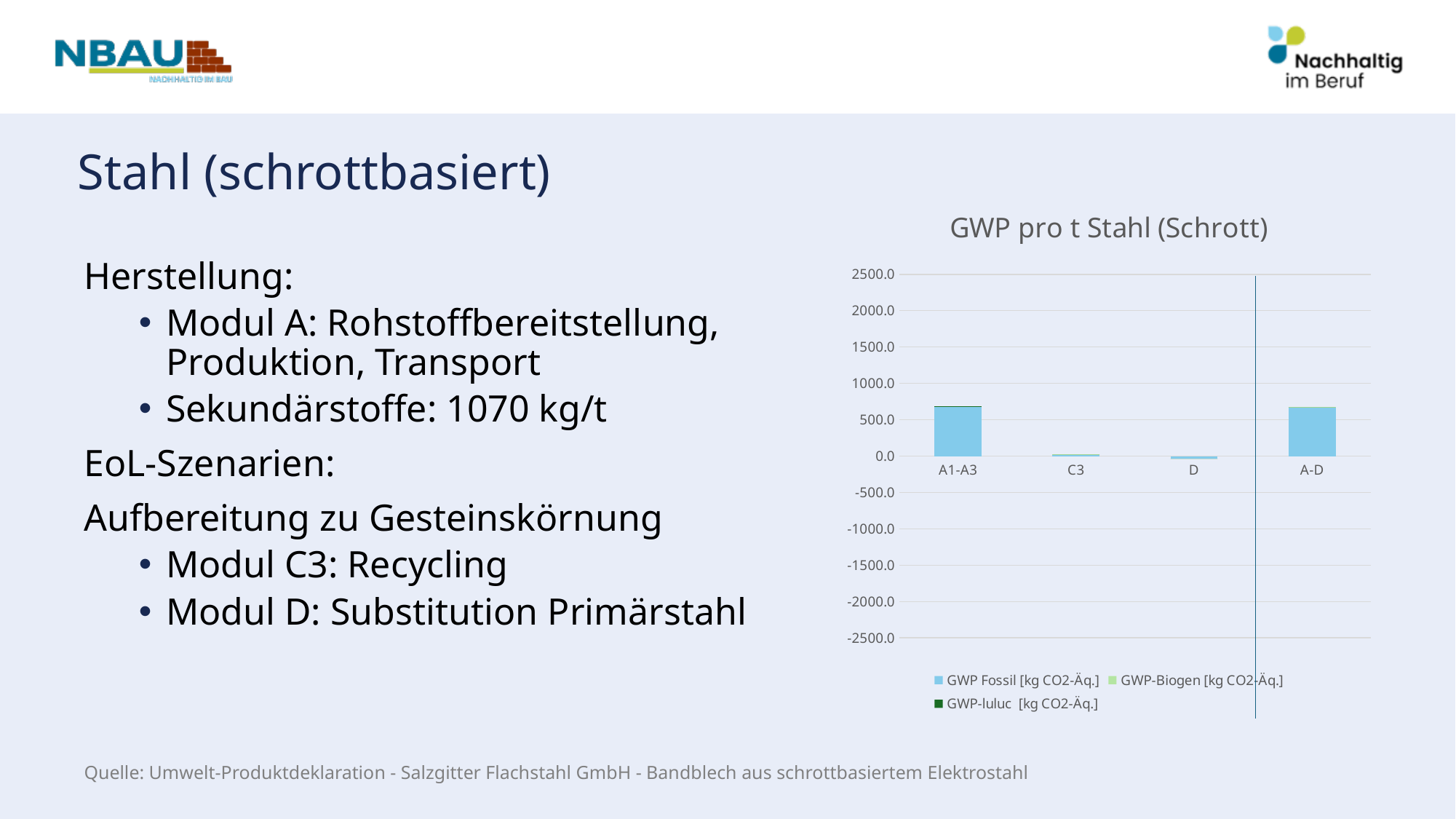
Which series is shown in light blue in the chart? GWP Fossil [kg CO2-Äq.] Which category has a larger GWP Fossil value, A1-A3 or C3? A1-A3 Is the GWP Fossil value for A-D greater or less than 1000? less Is the GWP Fossil value for D greater or less than 0? less Is the GWP Fossil value for C3 greater or less than 500? less How many series does the chart's legend list? 3 What is the title of the chart on the slide? GWP pro t Stahl (Schrott) How many categories are shown on the x axis of the chart? 4 What kind of chart is shown on the slide? bar chart